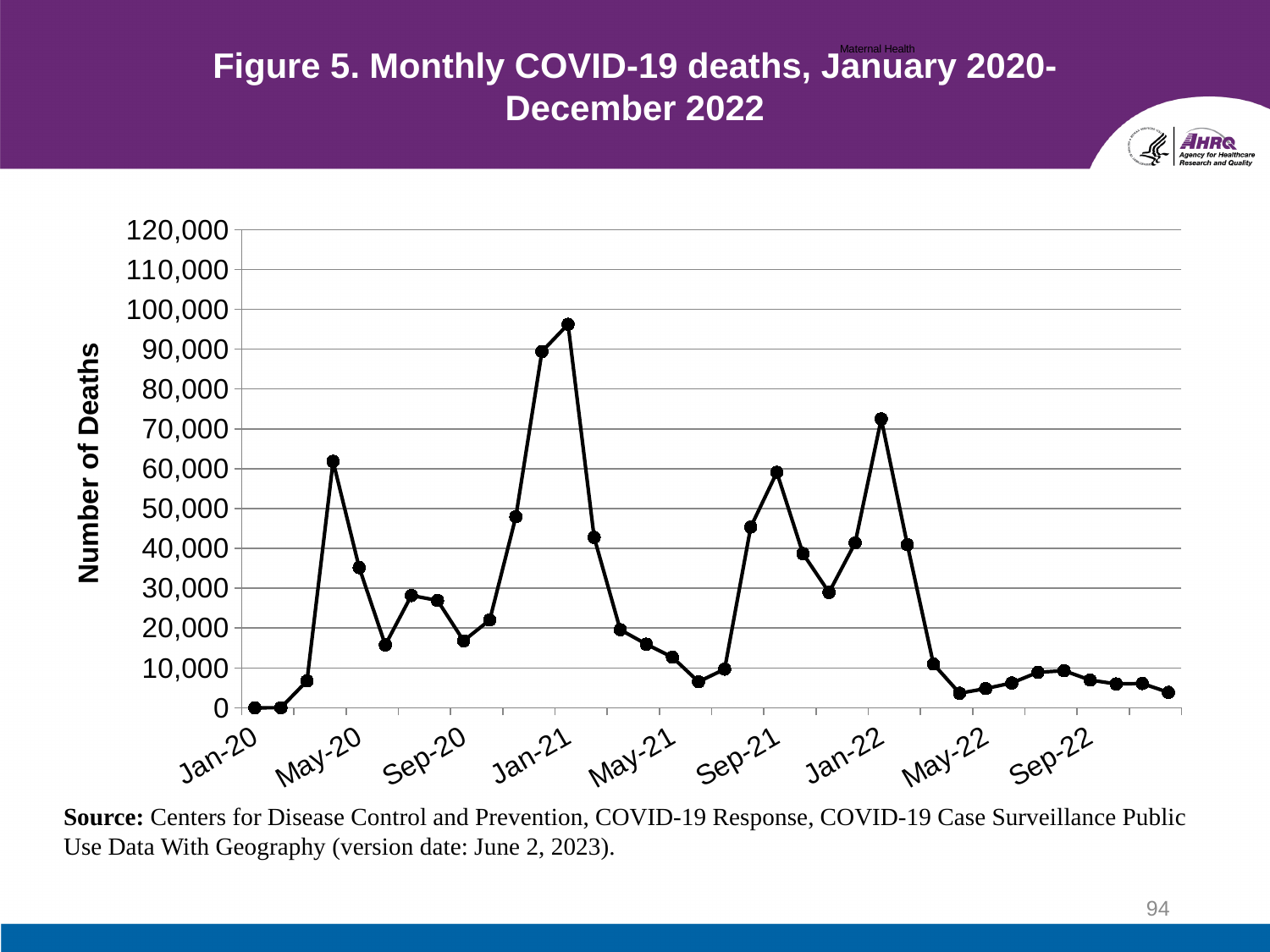
Which month has the highest number of COVID-19 deaths? Jan-21 Which month has more COVID-19 deaths, Sep-21 or Sep-22? Sep-21 What is the label on the vertical axis of the chart? Number of Deaths Do the monthly deaths rise or fall from Jan-21 to May-21? fall Which month has the lowest number of COVID-19 deaths? Jan-20 Is the value for Jan-22 greater or less than 60,000? greater Is the value for May-22 greater or less than 10,000? less Is the value for Jan-21 greater or less than 90,000? greater What kind of chart is shown on the slide? line chart Which month has more COVID-19 deaths, Jan-21 or Jan-22? Jan-21